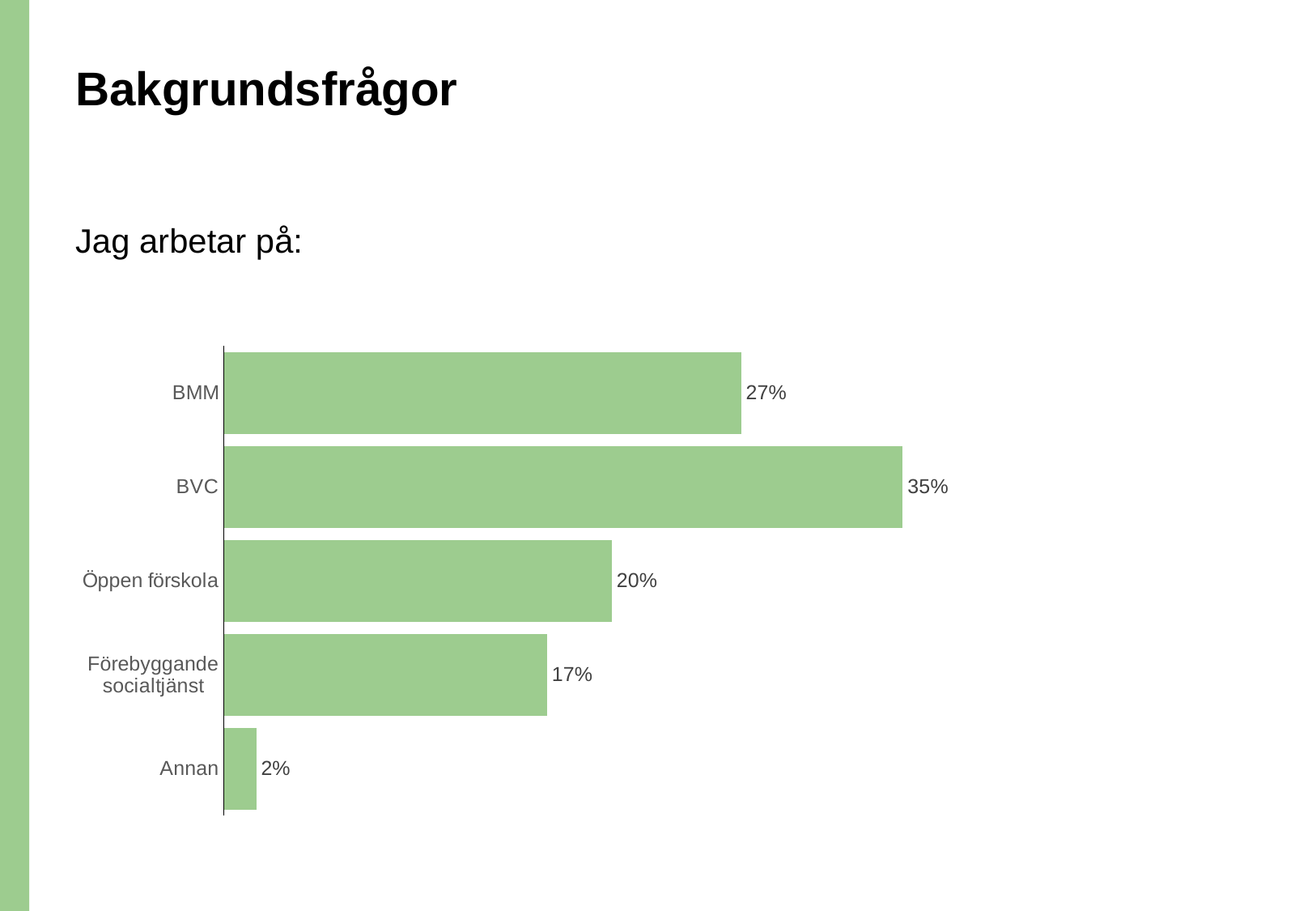
What is the value for BVC? 35% What kind of chart is shown on the slide? Bar chart What is the value for Annan? 2% Which category has the lowest value? Annan What is the value for Förebyggande socialtjänst? 17% What is the difference between the values for BVC and BMM? 8% How many categories are shown in the chart? 5 What is the text shown above the chart describing what it measures? Jag arbetar på: What is the value for Öppen förskola? 20% What is the value for BMM? 27% Which category has the highest value? BVC Which is larger, the value for Öppen förskola or the value for Förebyggande socialtjänst? Öppen förskola